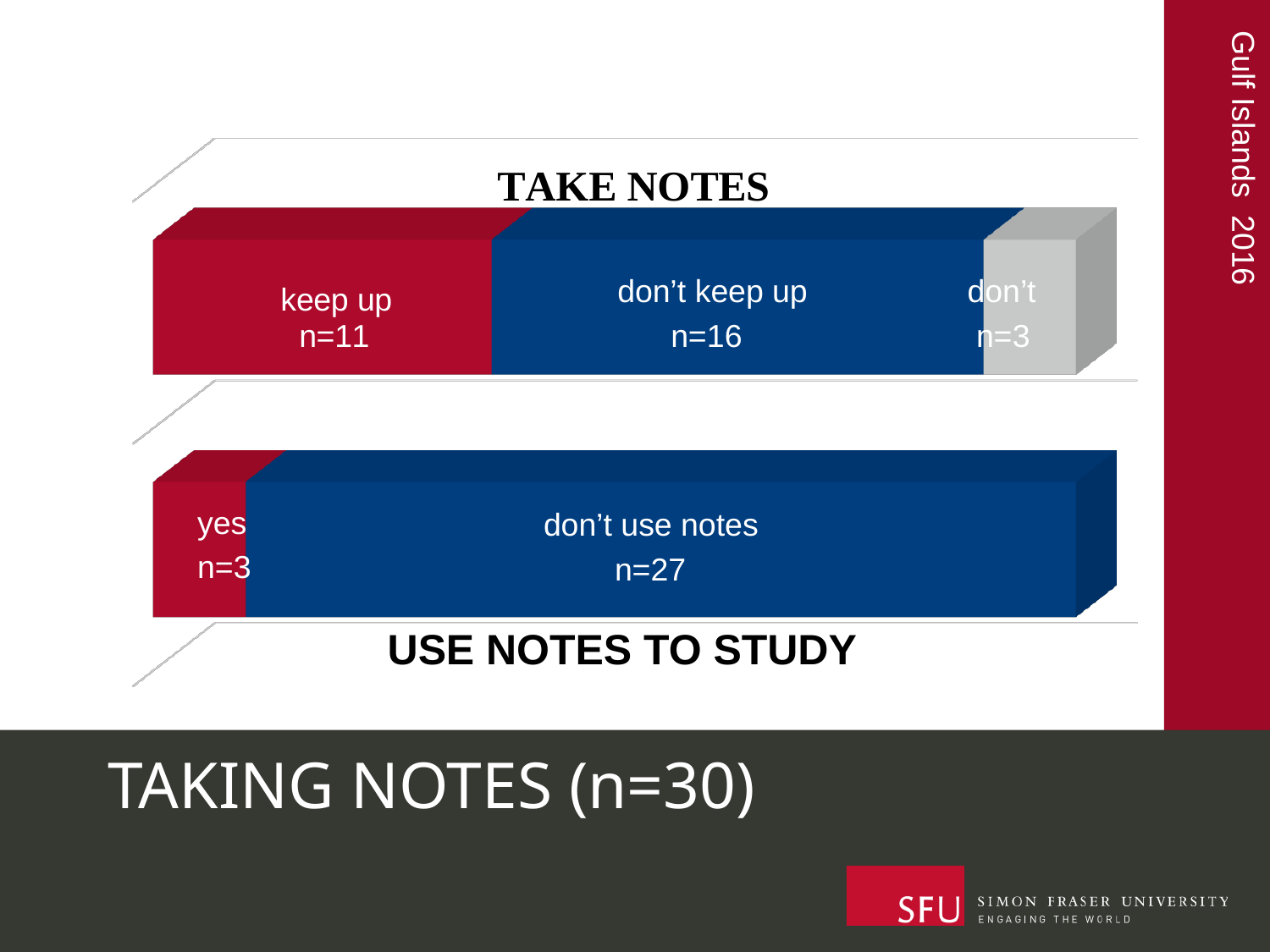
In the TAKE NOTES bar, what is the value for "don't keep up"? n=16 In the USE NOTES TO STUDY bar, what is the value for "yes"? n=3 What is the total of the TAKE NOTES stacked bar? 30 What kind of chart is shown on the slide? stacked bar chart In the USE NOTES TO STUDY bar, what is the value for "don't use notes"? n=27 In the TAKE NOTES bar, which segment is the largest? don't keep up In the TAKE NOTES bar, what is the difference between "don't keep up" and "keep up"? 5 In the USE NOTES TO STUDY bar, which is larger, "yes" or "don't use notes"? don't use notes In the TAKE NOTES bar, which segment is the smallest? don't In the TAKE NOTES bar, what is the value for "keep up"? n=11 How many segments does the TAKE NOTES bar have? 3 In the TAKE NOTES bar, what is the value for "don't"? n=3